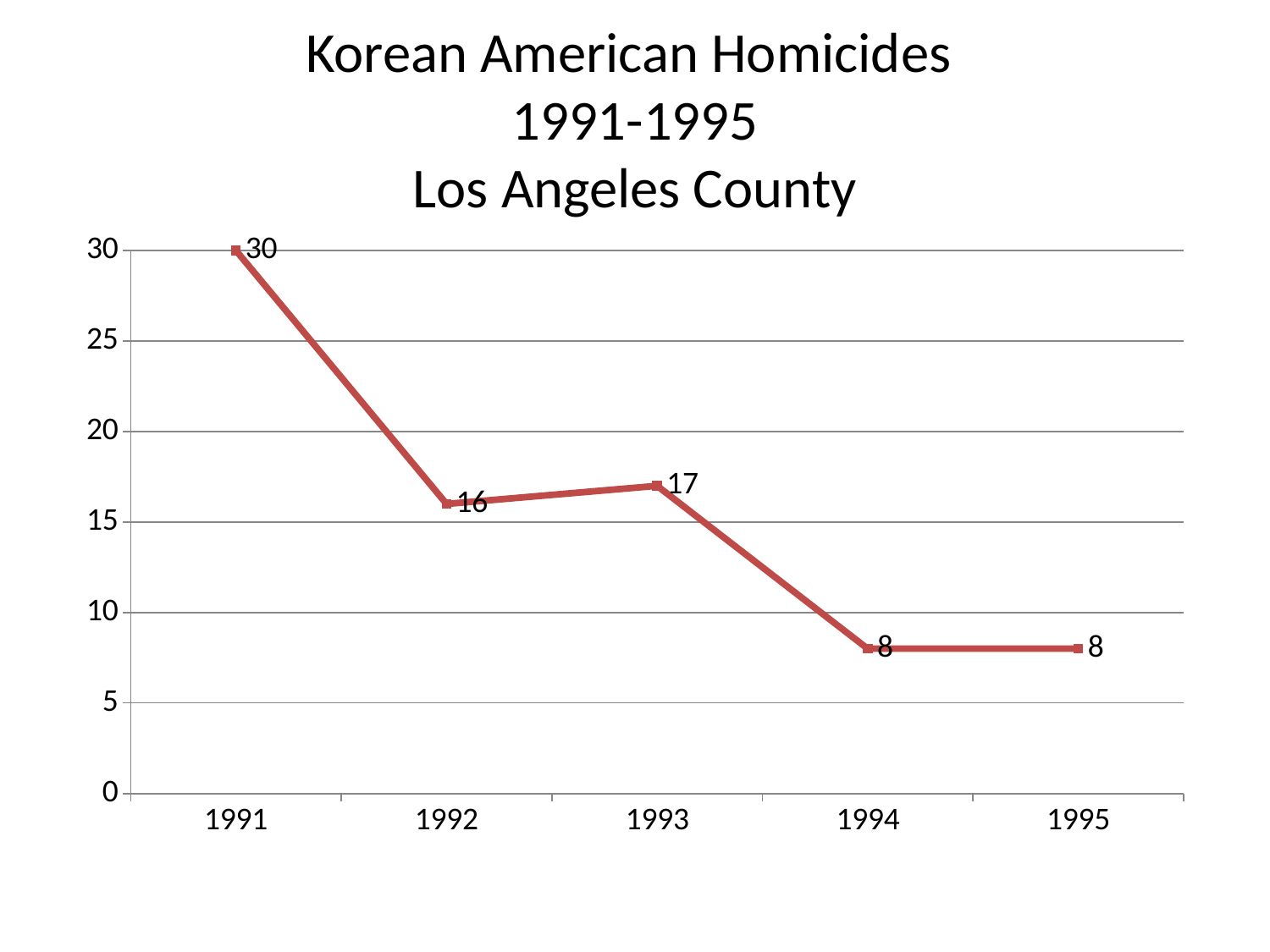
What is the title of the chart? Korean American Homicides 1991-1995 Los Angeles County Do the values generally rise or fall from 1991 to 1995? fall What kind of chart is shown on the slide? line chart Is the value for 1992 greater or less than 20? less What is the number of Korean American homicides in 1995? 8 What is the difference in homicides between 1991 and 1992? 14 What is the number of Korean American homicides in 1993? 17 Which year has more homicides, 1992 or 1993? 1993 How many years are plotted on the chart? 5 What is the difference in homicides between 1993 and 1994? 9 Which year has the highest number of homicides? 1991 What is the number of Korean American homicides in 1991? 30